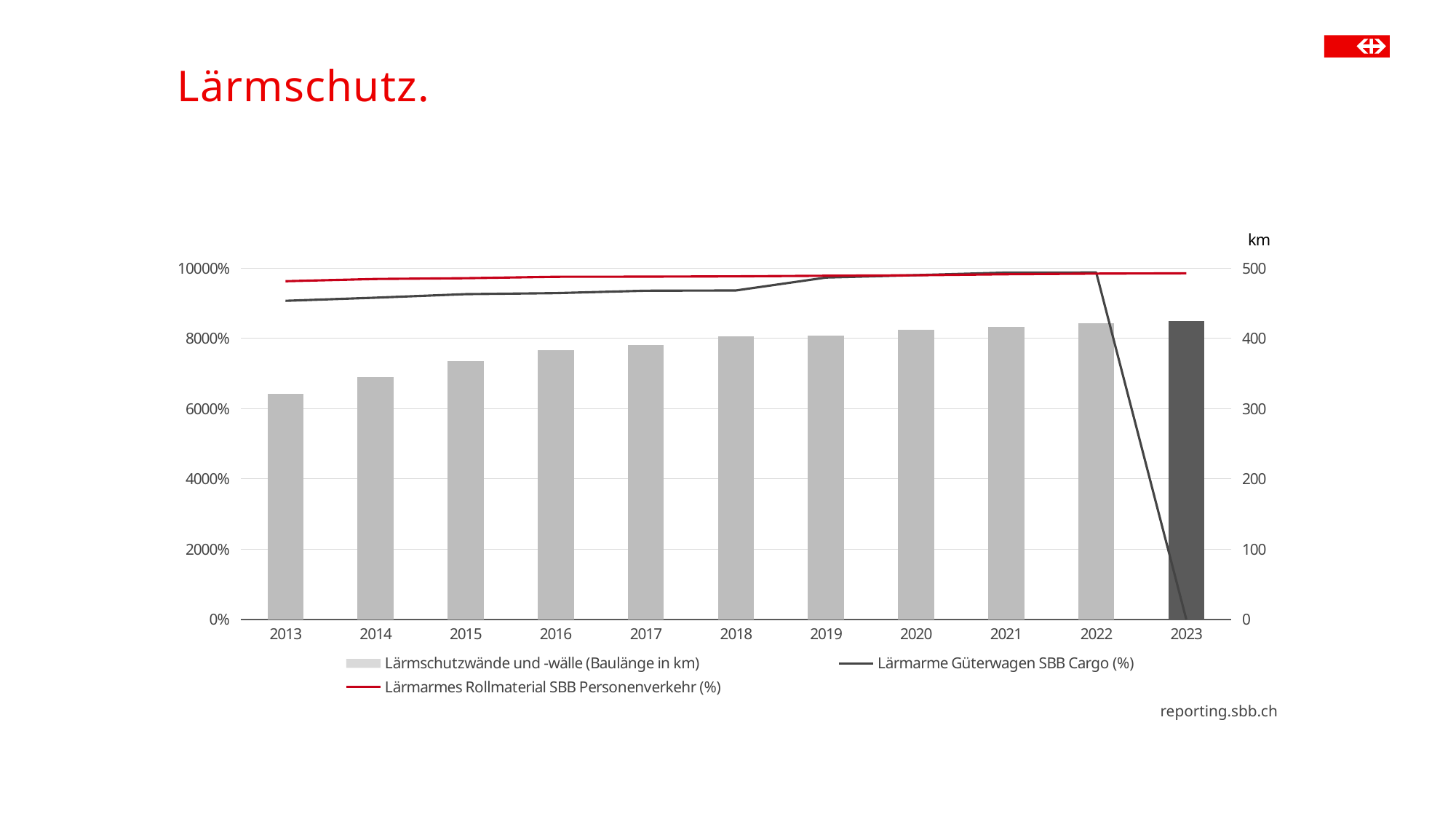
How many series does the chart legend list? 3 Do the bars for Lärmschutzwände und -wälle rise or fall from 2013 to 2023? Rise Is the value for Lärmarme Güterwagen SBB Cargo in 2013 greater or less than 8000%? greater Is the value for Lärmschutzwände und -wälle in 2013 greater or less than 400 km? less What kind of chart is shown on the slide? A combined bar and line chart Which year has the lowest bar for Lärmschutzwände und -wälle (Baulänge in km)? 2013 How many years are shown on the x axis of the chart? 11 Is the value for Lärmschutzwände und -wälle in 2023 greater or less than 400 km? greater Which is larger, the bar for Lärmschutzwände und -wälle in 2013 or in 2014? 2014 What is the title of the slide? Lärmschutz. Which series is drawn as a red line in the chart? Lärmarmes Rollmaterial SBB Personenverkehr (%)